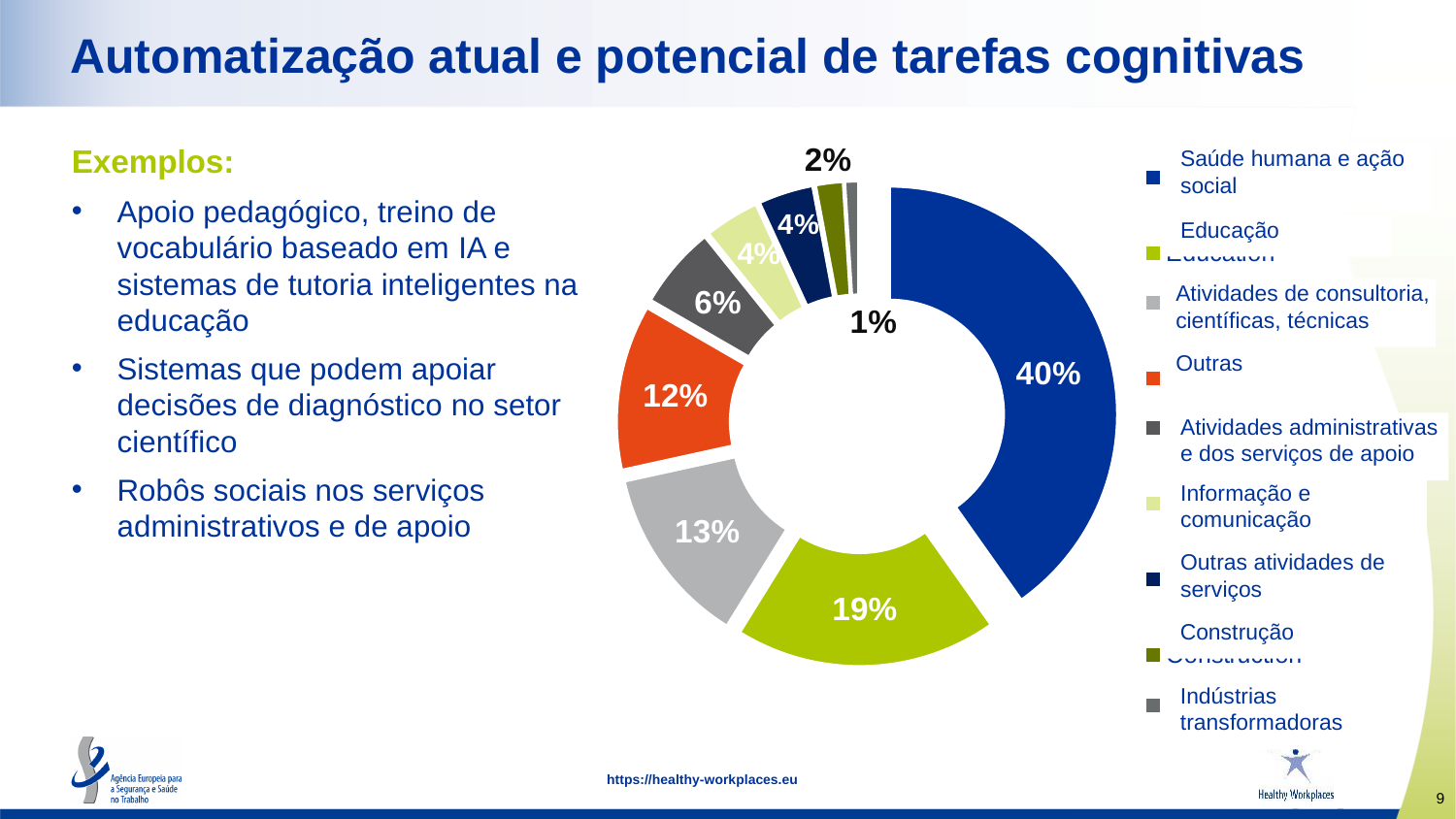
What percentage is shown for Educação? 19% What percentage is shown for Atividades de consultoria, científicas, técnicas? 13% What is the combined share of Saúde humana e ação social and Educação? 59% Which is larger: the share for Outras or the share for Atividades administrativas e dos serviços de apoio? Outras Which category has the largest share of the chart? Saúde humana e ação social What is the difference in percentage points between Saúde humana e ação social and Educação? 21 percentage points Which category has the smallest share of the chart? Indústrias transformadoras How many categories does the legend list? 9 What kind of chart is shown on the slide? Doughnut (pie) chart What percentage is shown for Saúde humana e ação social? 40% What percentage is shown for Outras? 12% What percentage is shown for Construção? 2%